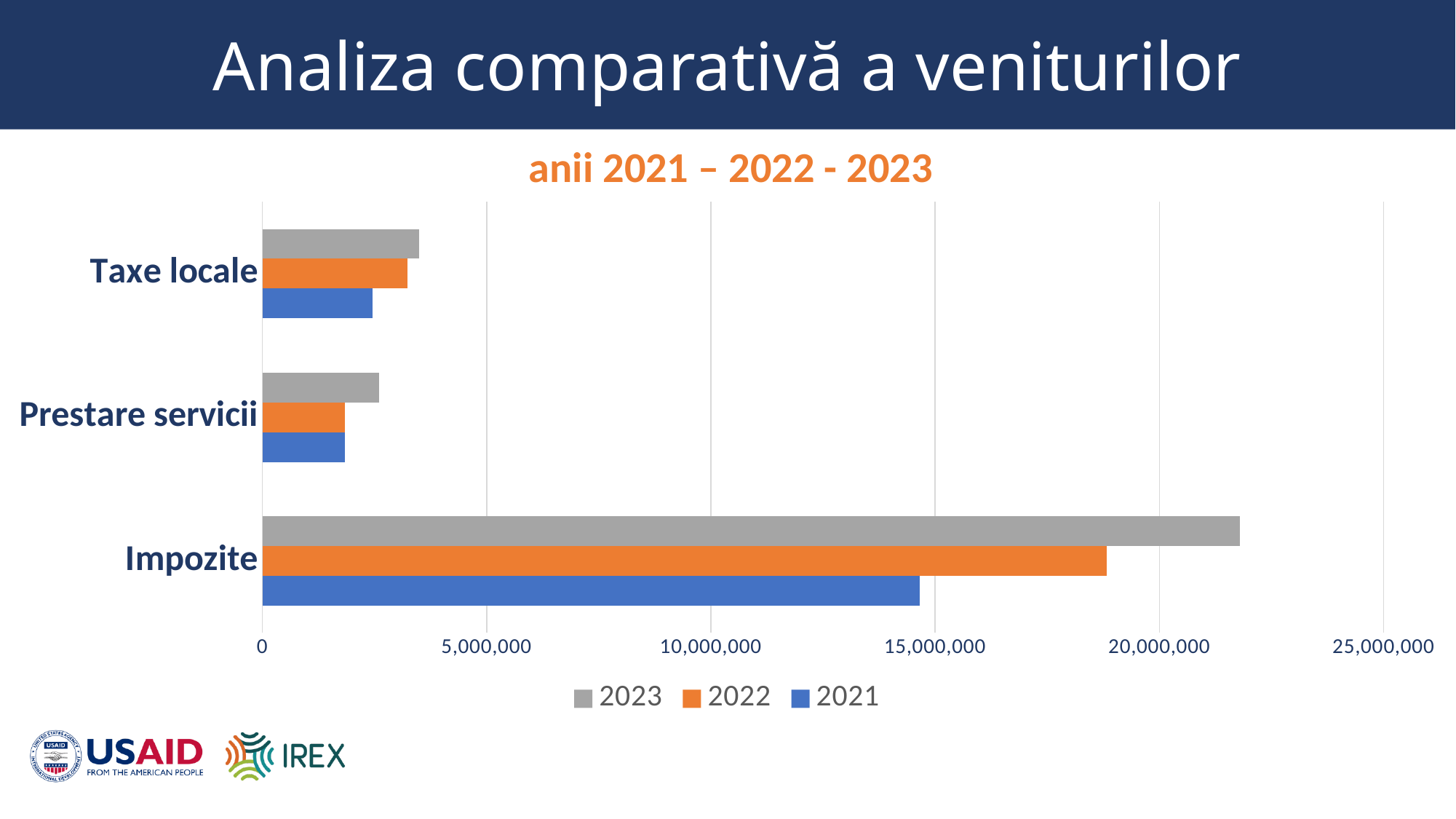
Which category has the highest value for 2023? Impozite For Impozite, which is larger: the value for 2023 or the value for 2022? 2023 How many series does the legend list? 3 Is the value for Impozite in 2022 greater or less than 15,000,000? greater Is the value for Impozite in 2021 greater or less than 15,000,000? less For Impozite, do the values rise or fall from 2021 to 2023? rise Which series is shown in orange in the legend? 2022 Is the value for Impozite in 2023 greater or less than 20,000,000? greater How many categories are shown on the chart? 3 What kind of chart is shown on the slide? bar chart Which category has the lowest value for 2023? Prestare servicii